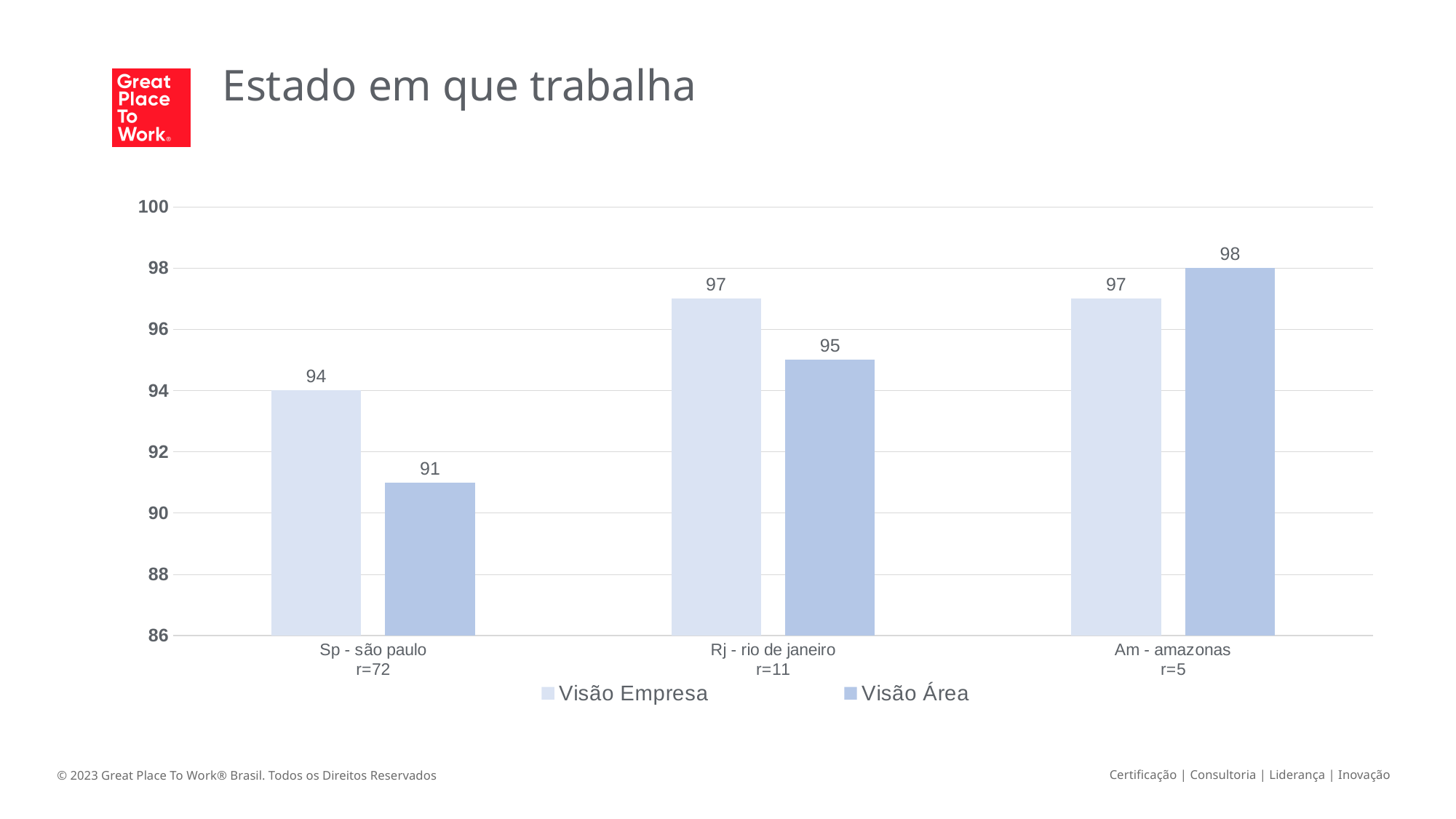
What is the Visão Área value for Am - amazonas? 98 How many categories are shown on the x axis? 3 How many series does the legend list? 2 What is the difference between the Visão Empresa and Visão Área values for Sp - são paulo? 3 Is the Visão Área value for Sp - são paulo greater or less than 92? less Which category has the highest Visão Área value? Am - amazonas What is the Visão Empresa value for Sp - são paulo? 94 What kind of chart is shown on the slide? bar chart What is the title of the slide? Estado em que trabalha Which category has the lowest Visão Área value? Sp - são paulo Which is larger for Rj - rio de janeiro: Visão Empresa or Visão Área? Visão Empresa What is the Visão Área value for Rj - rio de janeiro? 95